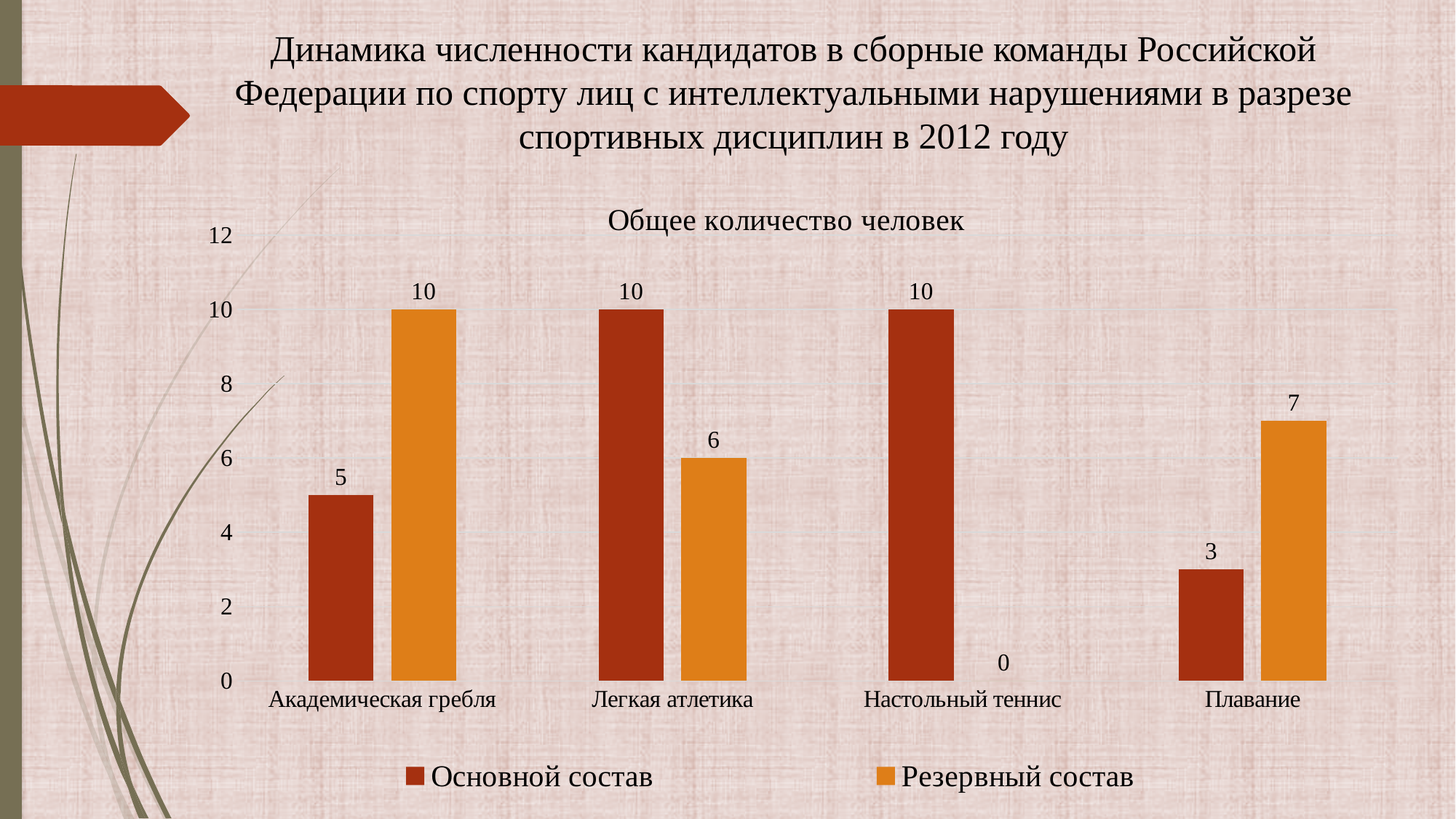
What is the value for Резервный состав in Настольный теннис? 0 What is the value for Резервный состав in Легкая атлетика? 6 What kind of chart is shown on the slide? Bar chart What is the value for Резервный состав in Плавание? 7 Which is larger in Легкая атлетика: Основной состав or Резервный состав? Основной состав What is the value for Основной состав in Академическая гребля? 5 What is the difference between Резервный состав and Основной состав in Академическая гребля? 5 How many series does the legend list? 2 Which category has the highest value for Резервный состав? Академическая гребля Which category has the lowest value for Основной состав? Плавание How many categories are shown on the x axis? 4 What is the title of the chart? Общее количество человек